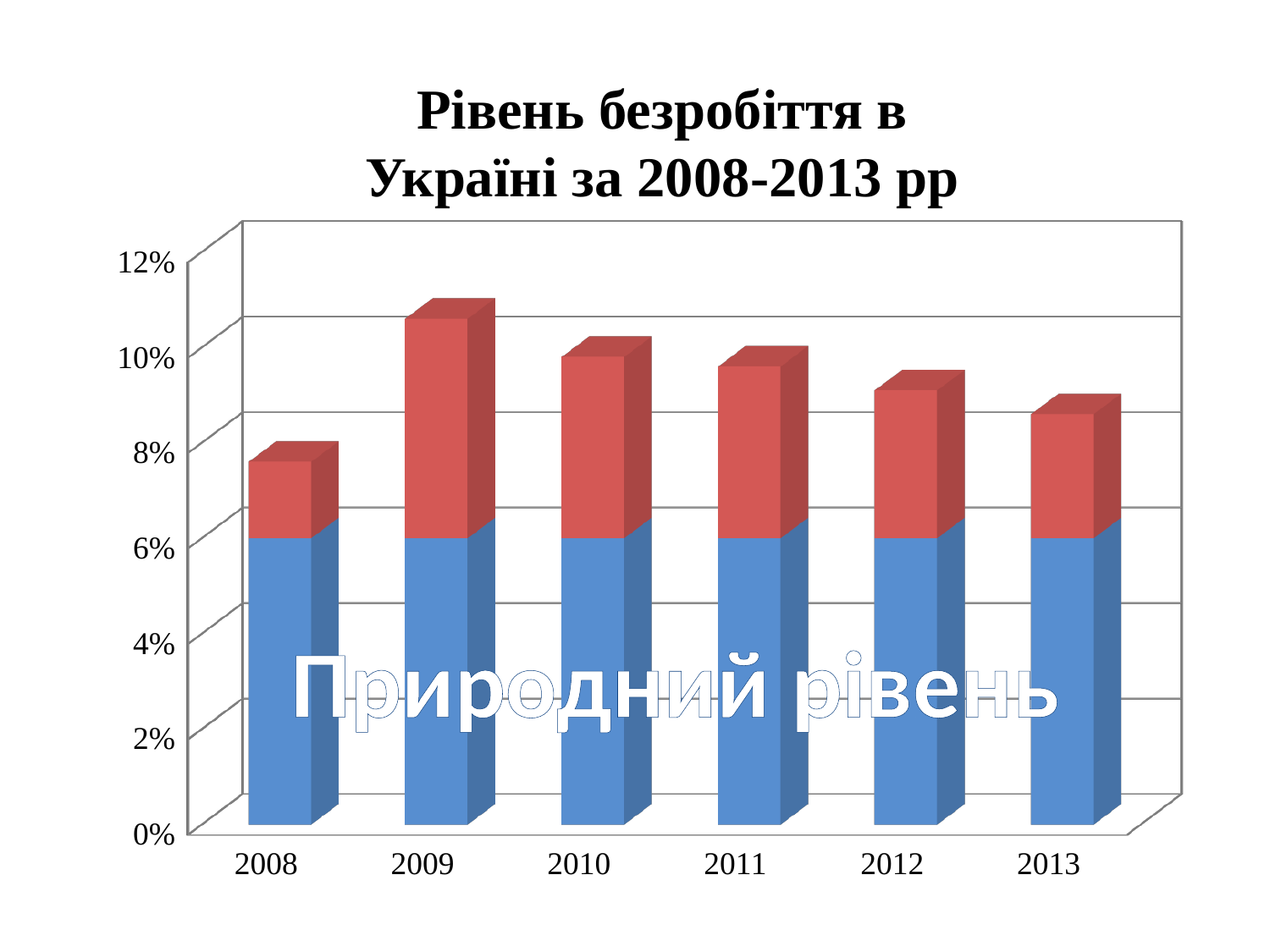
Do the unemployment rates rise or fall from 2009 to 2013? fall Which year has a higher unemployment rate, 2009 or 2013? 2009 Is the value for 2013 greater or less than 8%? greater Is the value for 2012 greater or less than 10%? less Is the value for 2009 greater or less than 10%? greater What kind of chart is shown on the slide? bar chart How many years are shown on the x axis of the chart? 6 What is the title of the chart? Рівень безробіття в Україні за 2008-2013 рр Which year has the lowest unemployment rate in the chart? 2008 Which year has the highest unemployment rate in the chart? 2009 Which year has a higher unemployment rate, 2010 or 2012? 2010